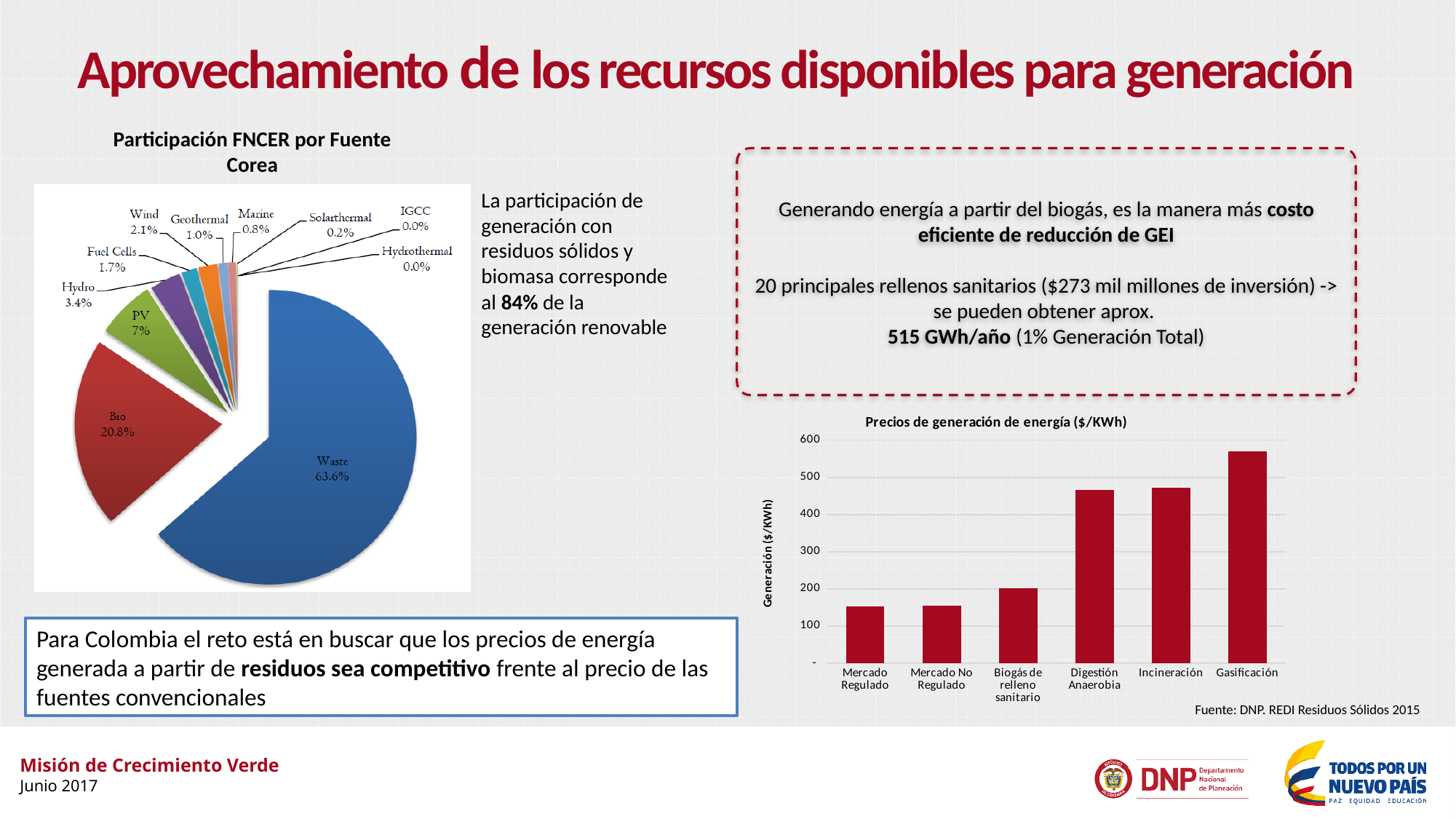
What kind of chart is 'Precios de generación de energía ($/KWh)'? Bar chart In the bar chart 'Precios de generación de energía ($/KWh)', is the value for Gasificación greater or less than 500? greater In the pie chart 'Participación FNCER por Fuente Corea', what is the difference between the Waste share and the Bio share? 42.8% In the bar chart 'Precios de generación de energía ($/KWh)', is the value for Mercado Regulado greater or less than 200? less In the pie chart 'Participación FNCER por Fuente Corea', what share does Bio have? 20.8% How many categories are shown in the bar chart 'Precios de generación de energía ($/KWh)'? 6 In the pie chart 'Participación FNCER por Fuente Corea', which source has the largest share? Waste How many sources are shown in the pie chart 'Participación FNCER por Fuente Corea'? 11 In the pie chart 'Participación FNCER por Fuente Corea', what share does Hydro have? 3.4% In the bar chart 'Precios de generación de energía ($/KWh)', which category has the highest value? Gasificación In the pie chart 'Participación FNCER por Fuente Corea', what share does Waste have? 63.6% In the pie chart 'Participación FNCER por Fuente Corea', which is larger, the share for PV or the share for Wind? PV